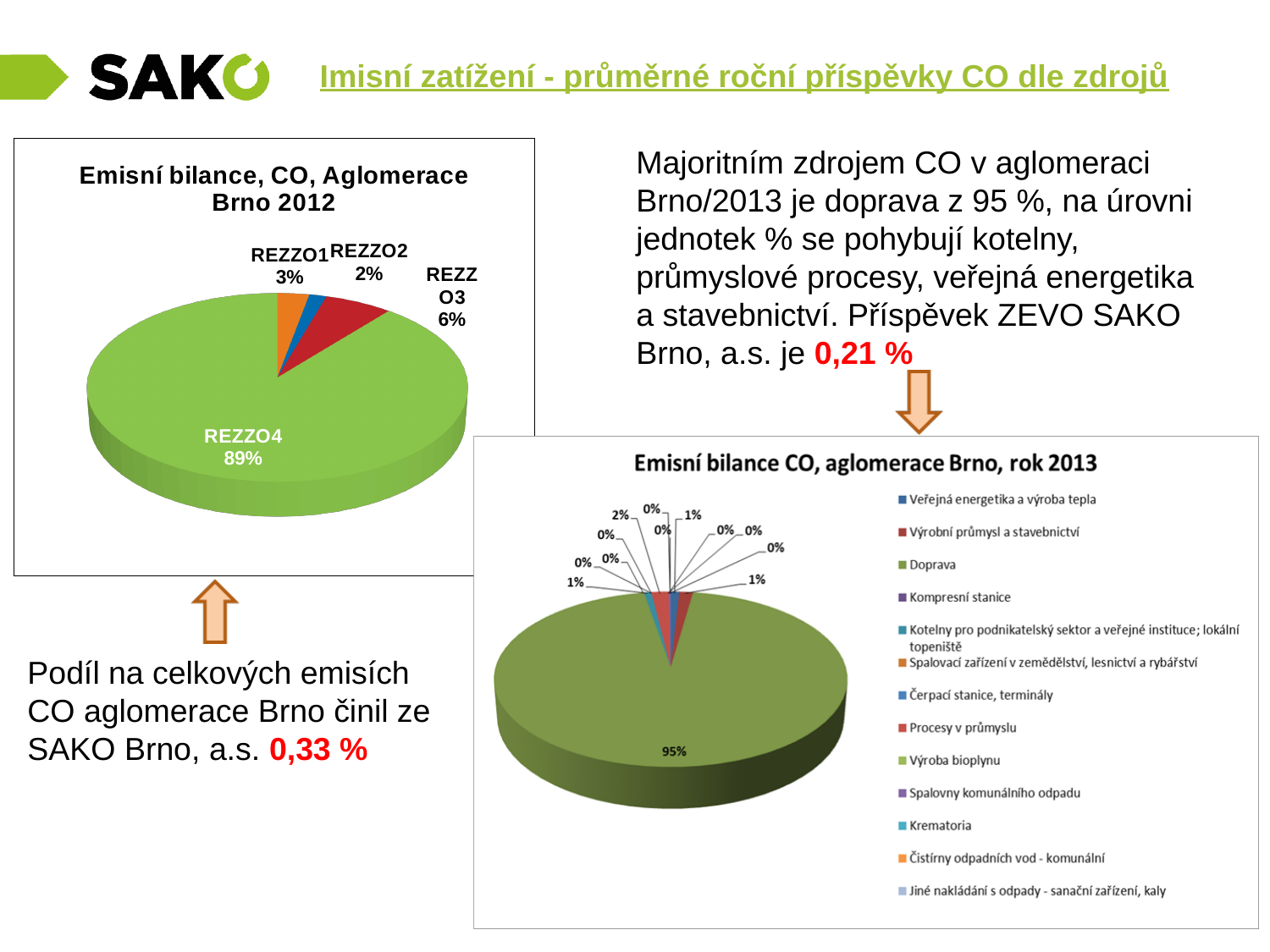
In the chart titled 'Emisní bilance, CO, Aglomerace Brno 2012', what share does REZZO4 have? 89% In the chart titled 'Emisní bilance, CO, Aglomerace Brno 2012', what share does REZZO3 have? 6% In the chart titled 'Emisní bilance, CO, Aglomerace Brno 2012', what is the difference in percentage points between REZZO3 and REZZO1? 3 percentage points In the chart titled 'Emisní bilance, CO, Aglomerace Brno 2012', what share does REZZO1 have? 3% What type of chart is the chart titled 'Emisní bilance CO, aglomerace Brno, rok 2013'? Pie chart How many entries does the legend of the chart titled 'Emisní bilance CO, aglomerace Brno, rok 2013' list? 13 How many categories are shown in the chart titled 'Emisní bilance, CO, Aglomerace Brno 2012'? 4 In the chart titled 'Emisní bilance, CO, Aglomerace Brno 2012', which is larger, REZZO1 or REZZO3? REZZO3 In the chart titled 'Emisní bilance, CO, Aglomerace Brno 2012', which category has the largest share? REZZO4 In the chart titled 'Emisní bilance, CO, Aglomerace Brno 2012', which category has the smallest share? REZZO2 In the chart titled 'Emisní bilance, CO, Aglomerace Brno 2012', what share does REZZO2 have? 2% In the chart titled 'Emisní bilance CO, aglomerace Brno, rok 2013', what share does the largest slice (Doprava) have? 95%